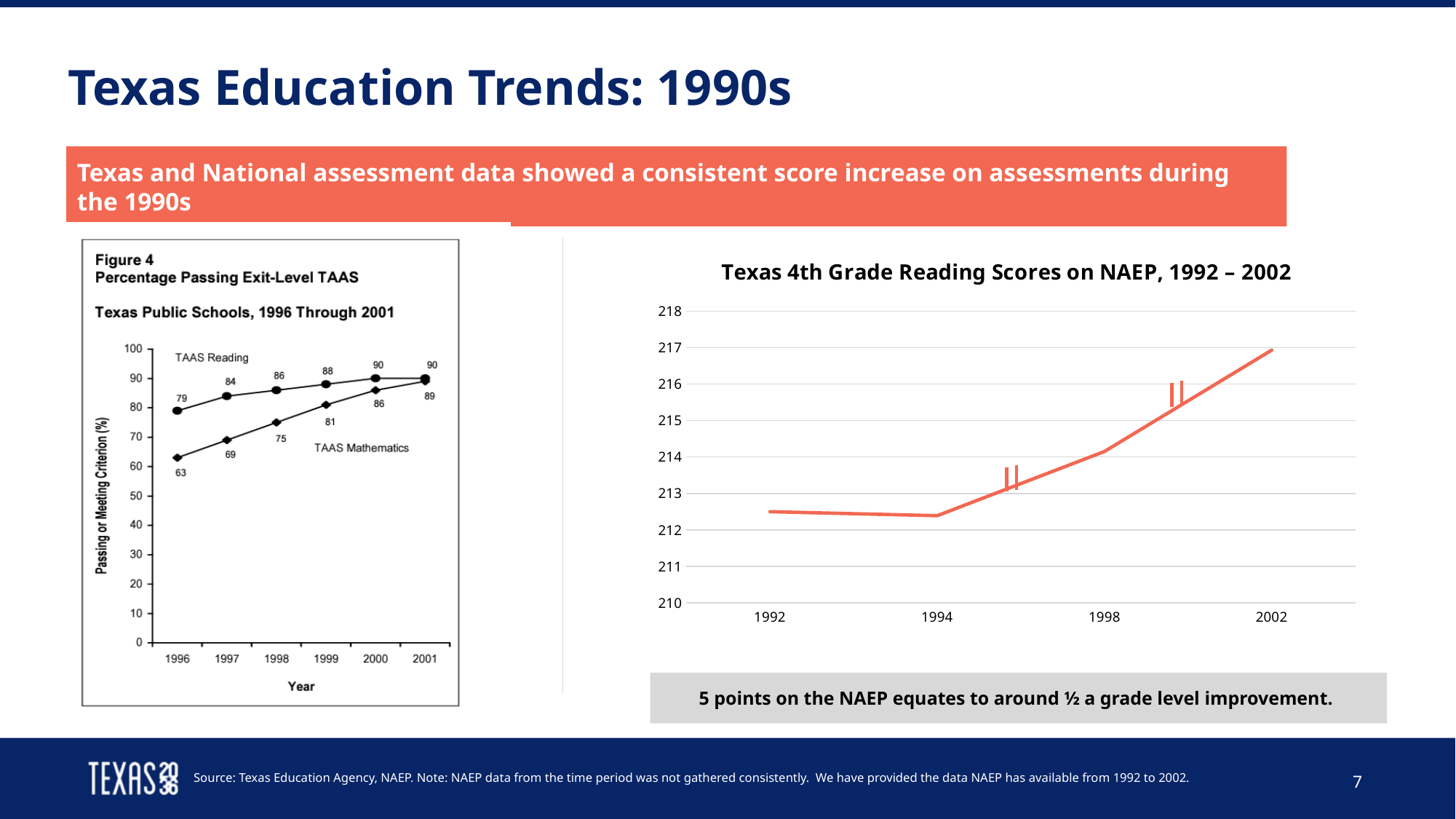
In the Figure 4 chart on the left, does the TAAS Mathematics passing percentage rise or fall from 1996 to 2001? rise In the 'Texas 4th Grade Reading Scores on NAEP, 1992 – 2002' chart, is the value for 2002 greater or less than 216? greater What kind of chart is the 'Texas 4th Grade Reading Scores on NAEP, 1992 – 2002' chart on the right? line chart In the Figure 4 chart on the left, what percentage passed TAAS Reading in 1996? 79 In the Figure 4 chart on the left, what is the difference between the TAAS Reading and TAAS Mathematics passing percentages in 1996? 16 In the Figure 4 chart on the left, what percentage passed TAAS Mathematics in 1999? 81 In the Figure 4 chart on the left, how many years are shown on the x axis? 6 In the Figure 4 chart on the left, which is higher in 1998: TAAS Reading or TAAS Mathematics? TAAS Reading In the 'Texas 4th Grade Reading Scores on NAEP, 1992 – 2002' chart, how many years are labelled on the x axis? 4 In the 'Texas 4th Grade Reading Scores on NAEP, 1992 – 2002' chart, is the value for 1994 greater or less than 213? less In the 'Texas 4th Grade Reading Scores on NAEP, 1992 – 2002' chart, which year has the highest score? 2002 In the Figure 4 chart on the left, which year has the lowest TAAS Mathematics passing percentage? 1996